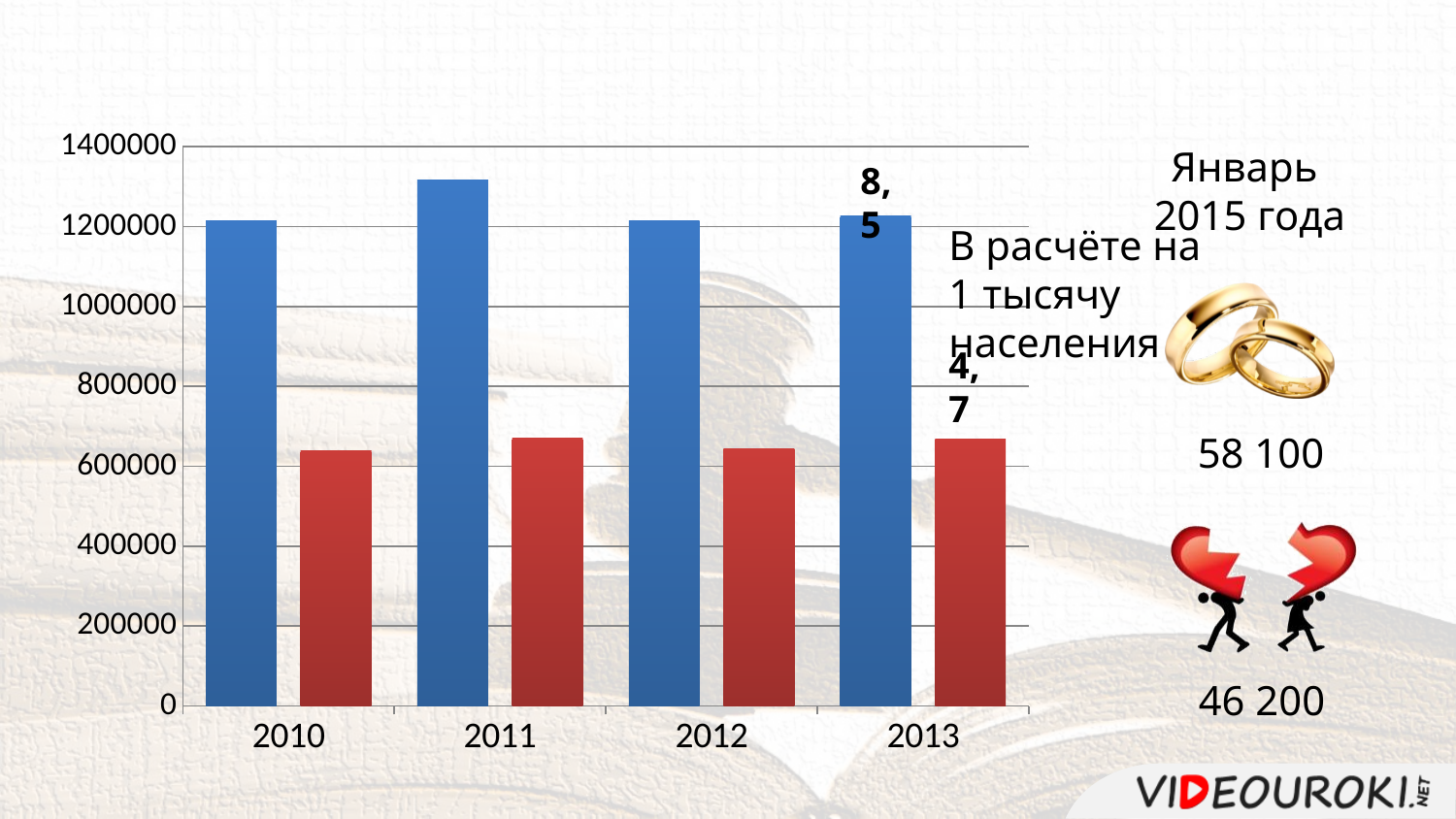
Which is larger, the blue bar for 2010 or the blue bar for 2011? 2011 What kind of chart is shown on the slide? bar chart What label is printed on the red bar for 2013? 4,7 In 2013, which bar is taller, the blue one or the red one? the blue one What label is printed on the blue bar for 2013? 8,5 Is the blue bar for 2011 greater or less than 1200000? greater Which year has the tallest blue bar? 2011 How many bars are shown for each year on the chart? 2 Is the red bar for 2010 greater or less than 600000? greater Is the red bar for 2013 greater or less than 800000? less How many years are shown on the x axis of the chart? 4